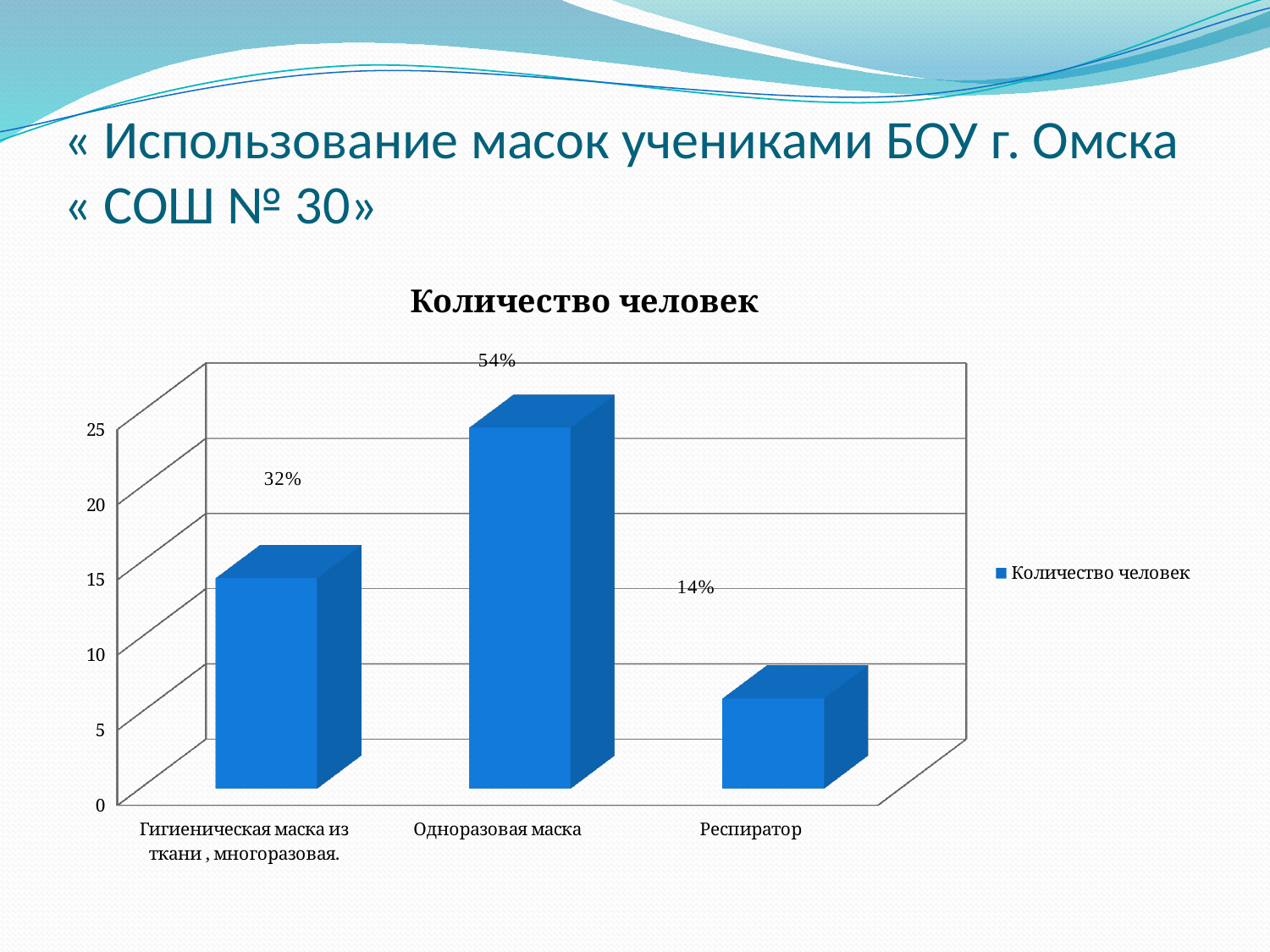
Which is larger, the value for Гигиеническая маска из ткани, многоразовая or the value for Респиратор? Гигиеническая маска из ткани, многоразовая What data label is shown for Респиратор? 14% How many categories are shown on the chart? 3 What is the title of the chart? Количество человек What data label is shown for Гигиеническая маска из ткани, многоразовая? 32% What is the difference between the data labels for Одноразовая маска and Гигиеническая маска из ткани, многоразовая? 22% Is the bar for Респиратор greater or less than 10 on the vertical axis? less Which category has the highest value? Одноразовая маска Is the bar for Одноразовая маска greater or less than 20 on the vertical axis? greater What data label is shown for Одноразовая маска? 54% What is the difference between the data labels for Одноразовая маска and Респиратор? 40% Which category has the lowest value? Респиратор